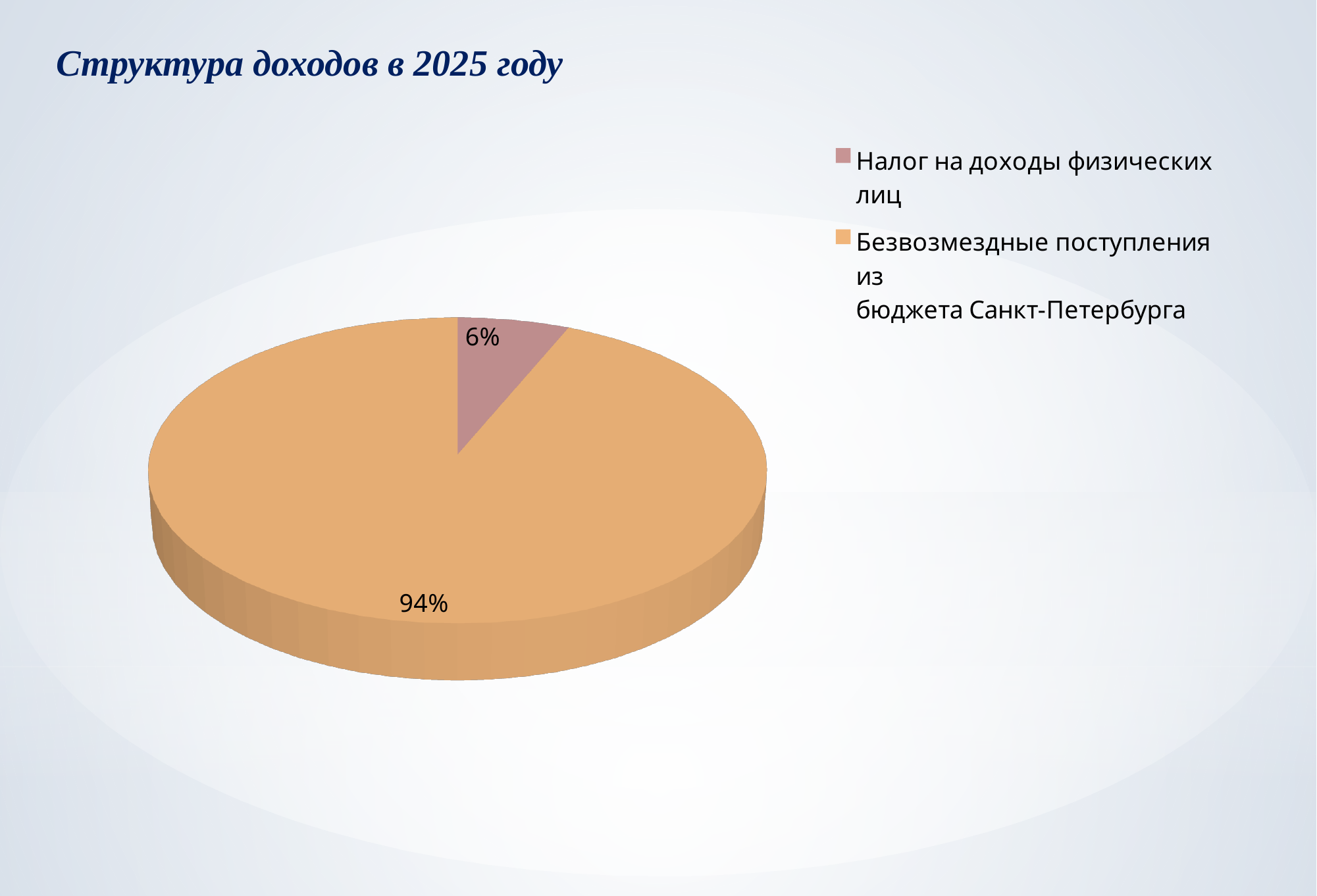
What is the title of the slide? Структура доходов в 2025 году Which is larger: the slice for "Налог на доходы физических лиц" or the slice for "Безвозмездные поступления из бюджета Санкт-Петербурга"? Безвозмездные поступления из бюджета Санкт-Петербурга What colour is the slice for "Налог на доходы физических лиц"? Pink (mauve) How many slices does the pie chart have? 2 What share of the pie does "Безвозмездные поступления из бюджета Санкт-Петербурга" represent? 94% How many entries does the legend list? 2 Which category has the largest slice of the pie? Безвозмездные поступления из бюджета Санкт-Петербурга What share of the pie does "Налог на доходы физических лиц" represent? 6% What is the difference in percentage points between the two slices? 88 What kind of chart is shown on the slide? Pie chart Which category has the smallest slice of the pie? Налог на доходы физических лиц